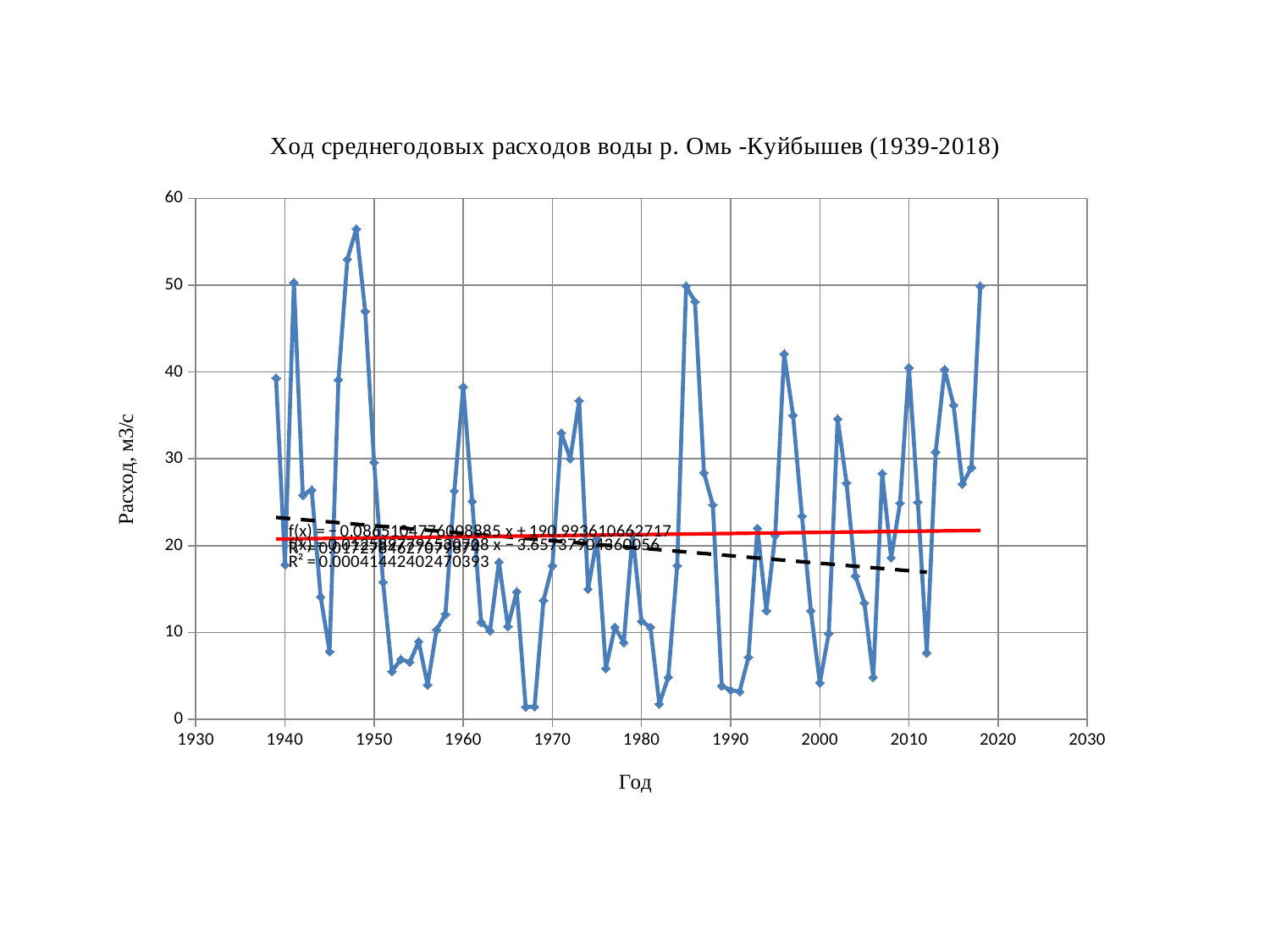
Is the value for 1948 greater or less than 50? greater What is the label of the vertical axis? Расход, м3/с Is the value for 1996 greater or less than 40? greater Is the value for 1960 greater or less than 30? greater What kind of chart is shown on the slide? line chart What is the title of the chart? Ход среднегодовых расходов воды р. Омь -Куйбышев (1939-2018) Which year has the larger value, 1948 or 1960? 1948 In which year does the series reach its highest value? 1948 Which year has the larger value, 1941 or 1945? 1941 Does the black dashed trend line rise or fall from left to right? fall